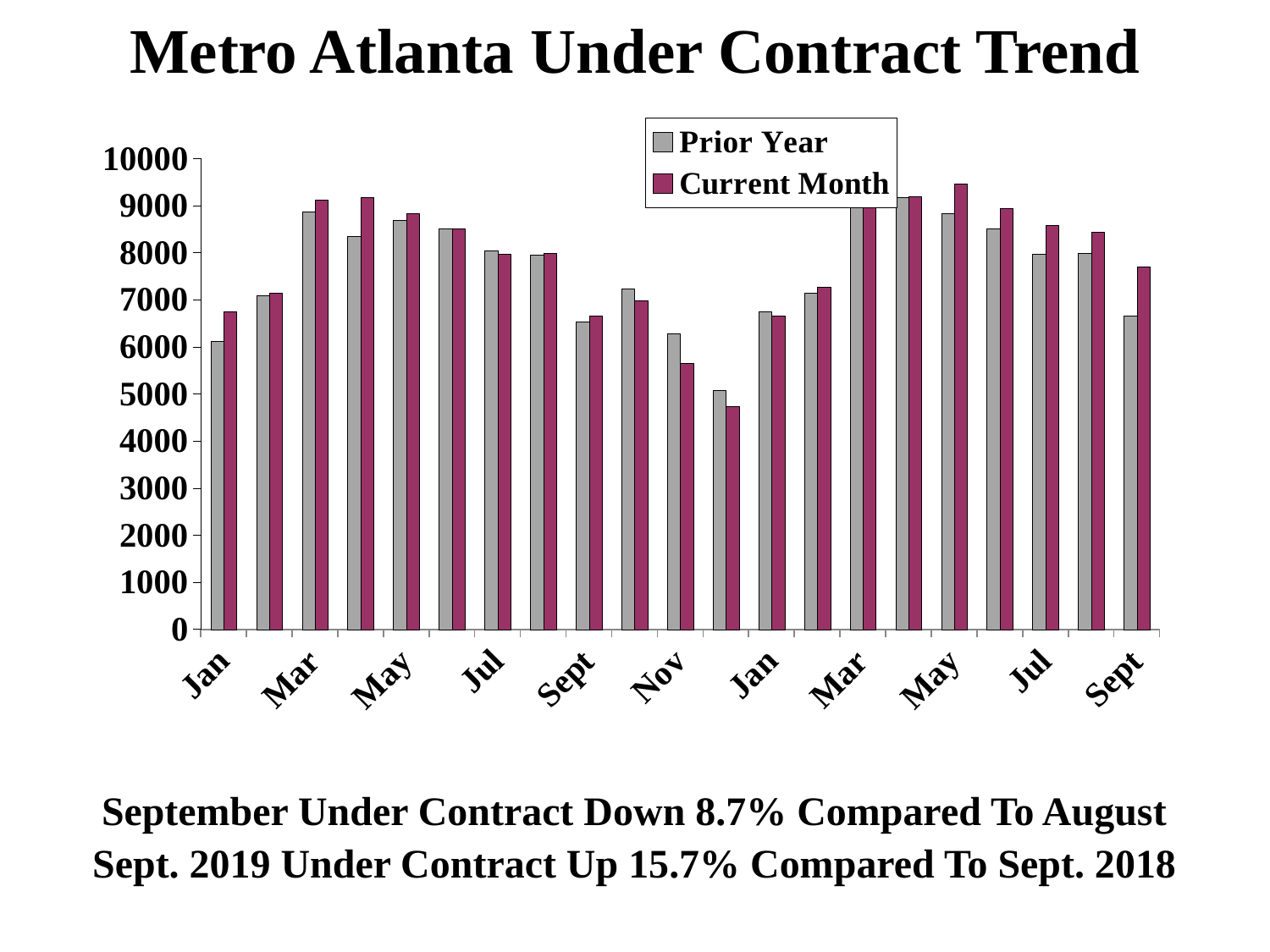
How many series does the legend list? 2 For Nov, which is larger: Prior Year or Current Month? Prior Year What kind of chart is shown on the slide? bar chart Is the Current Month value for the first Jan greater or less than 6000? greater Is the Prior Year value for the second Sept greater or less than 7000? less Do the Current Month values rise or fall from Jul to Nov in the first year? fall What is the title of the chart? Metro Atlanta Under Contract Trend Is the Current Month value for Nov greater or less than 6000? less What are the two series named in the legend? Prior Year and Current Month Which month has the highest Current Month value? the second May For the first Jan, which is larger: Prior Year or Current Month? Current Month